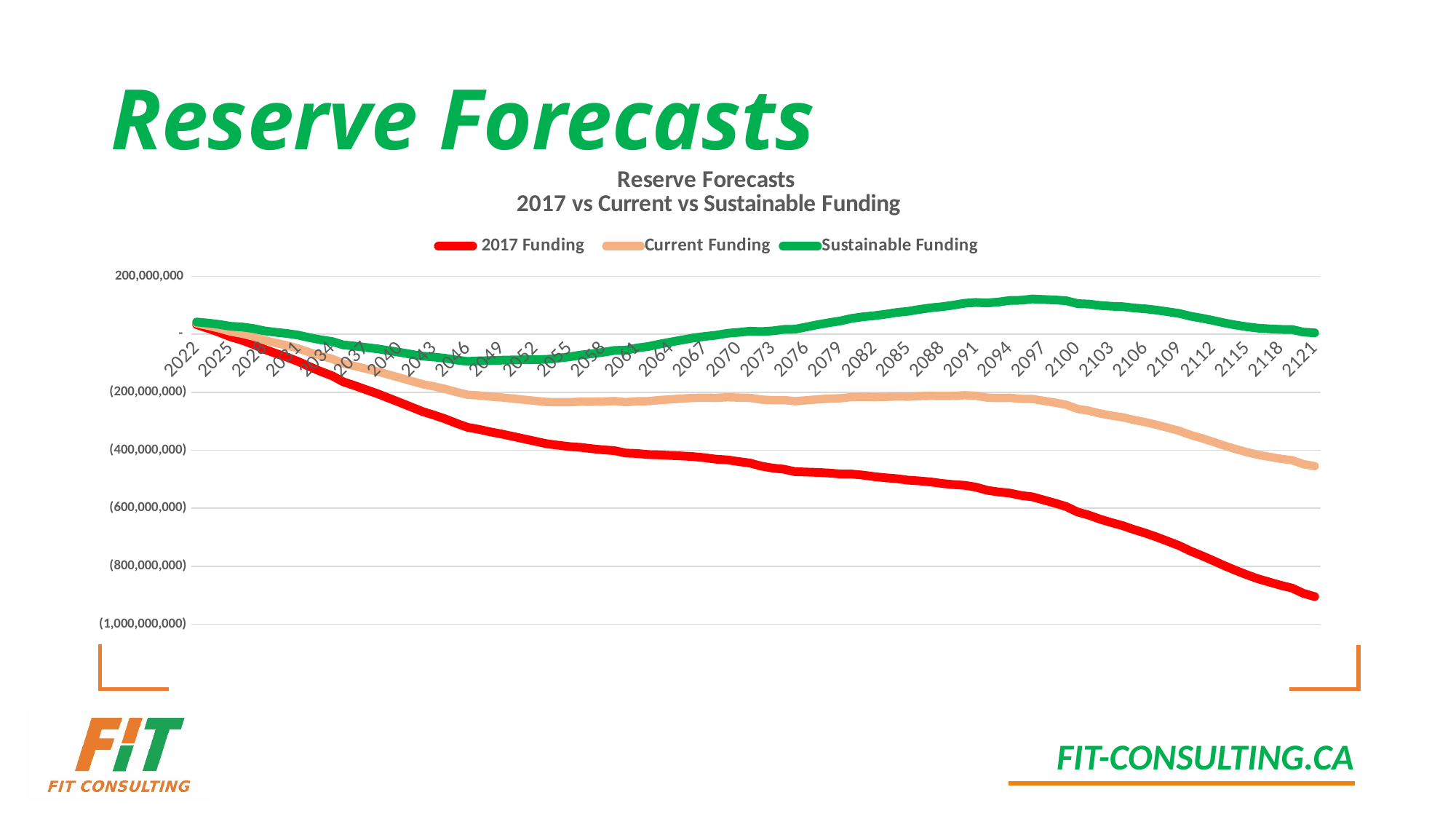
Is the value for 2017 Funding at 2121 greater or less than (800,000,000)? less Is the value for Current Funding at 2121 greater or less than (600,000,000)? greater Is the value for Sustainable Funding at 2097 greater or less than 0? greater What is the subtitle of the chart below 'Reserve Forecasts'? 2017 vs Current vs Sustainable Funding How many year labels are shown on the x axis? 34 How many series does the legend list? 3 Which series has the lowest value at 2121? 2017 Funding What kind of chart is shown on the slide? line chart Does the 2017 Funding line rise or fall from 2022 to 2121? fall At 2070, which is larger: Current Funding or 2017 Funding? Current Funding Which series has the highest value at 2121? Sustainable Funding What are the three series named in the legend? 2017 Funding, Current Funding, Sustainable Funding